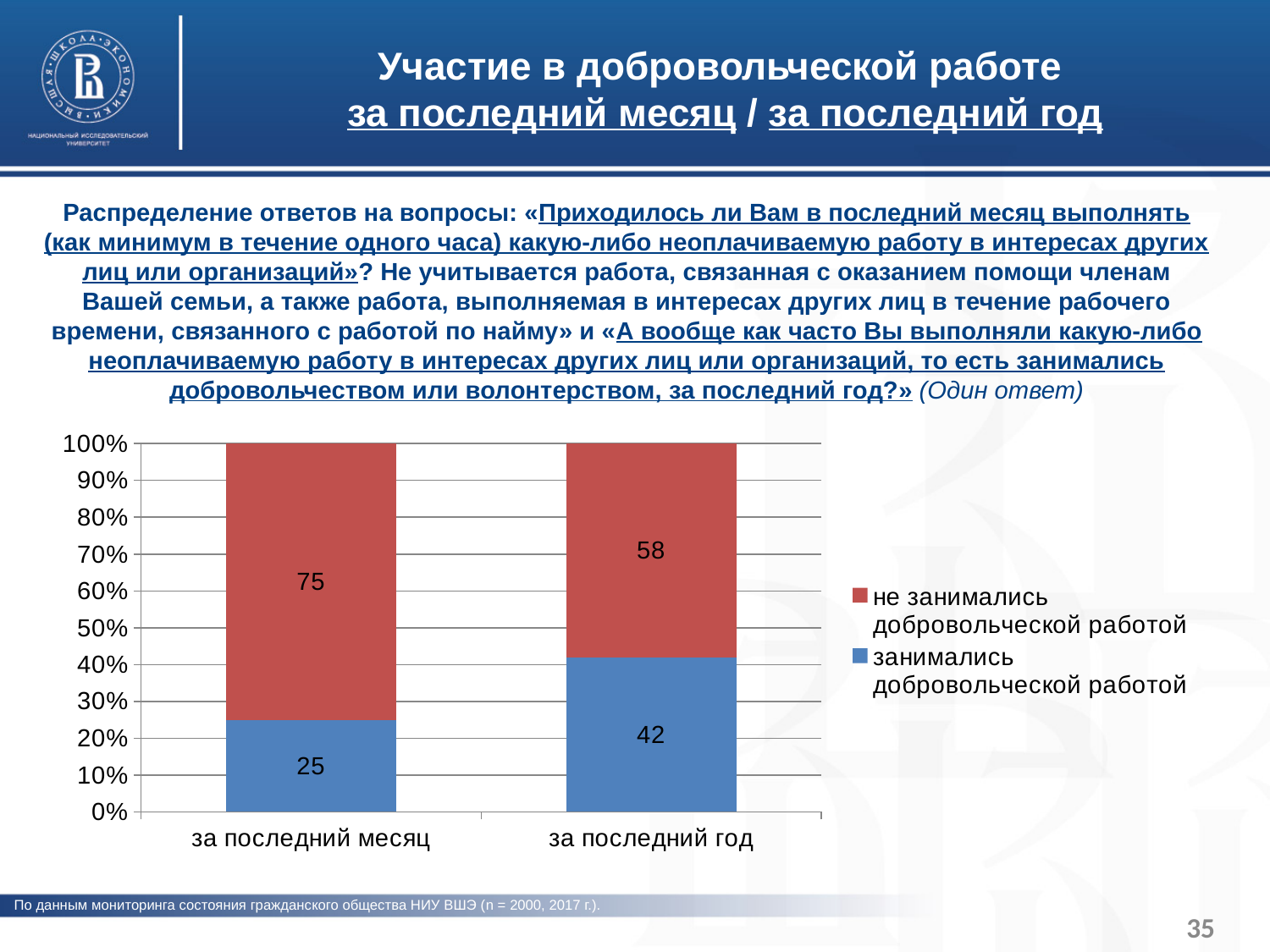
Which category has the lower value for «не занимались добровольческой работой»? за последний год What is the value for «не занимались добровольческой работой» in the «за последний год» bar? 58 What is the value for «занимались добровольческой работой» in the «за последний месяц» bar? 25 How many series does the legend list? 2 What is the value for «не занимались добровольческой работой» in the «за последний месяц» bar? 75 What is the difference between the «занимались добровольческой работой» values for «за последний год» and «за последний месяц»? 17 How many categories are shown on the x axis? 2 What is the value for «занимались добровольческой работой» in the «за последний год» bar? 42 Is the «не занимались добровольческой работой» value larger for «за последний месяц» or «за последний год»? за последний месяц Which category has the higher value for «занимались добровольческой работой»? за последний год What colour represents «занимались добровольческой работой» in the chart? blue What kind of chart is shown on the slide? stacked bar chart